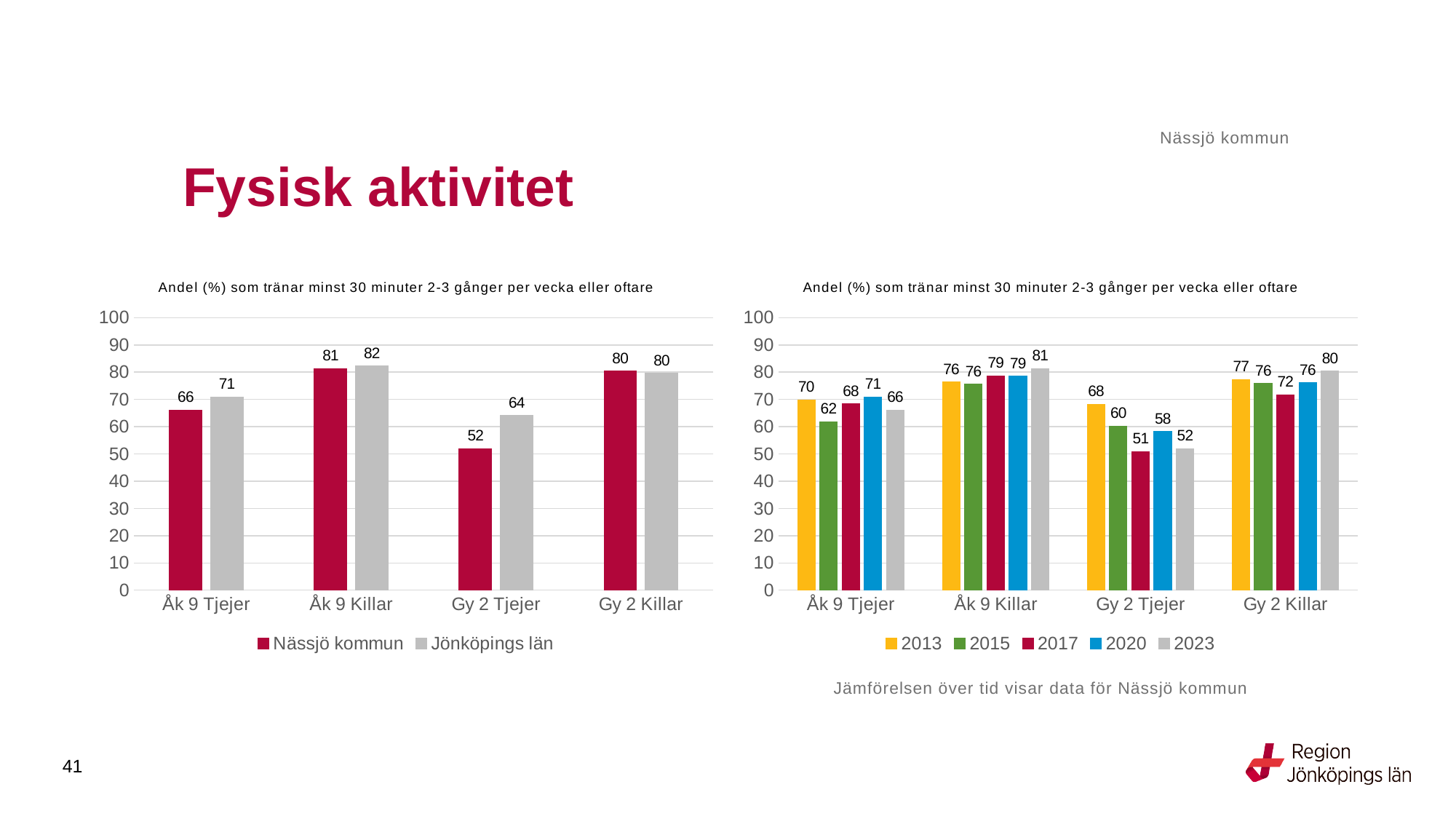
In the right chart, what is the value for 2017 for Gy 2 Tjejer? 51 In the left chart, what is the value for Jönköpings län for Åk 9 Killar? 82 In the left chart, which category has the lowest value for Nässjö kommun? Gy 2 Tjejer In the right chart, how many series does the legend list? 5 In the left chart, what is the value for Nässjö kommun for Gy 2 Tjejer? 52 In the right chart, what is the difference between the 2013 and 2023 values for Gy 2 Tjejer? 16 In the right chart, is the value for 2013 for Åk 9 Tjejer larger than the value for 2015 for Åk 9 Tjejer? Yes In the left chart, how many series does the legend list? 2 In the right chart, what is the value for 2023 for Åk 9 Killar? 81 In the right chart, which year has the highest value for Gy 2 Killar? 2023 What kind of chart is the left chart? Bar chart In the left chart, what is the difference between Jönköpings län and Nässjö kommun for Gy 2 Tjejer? 12